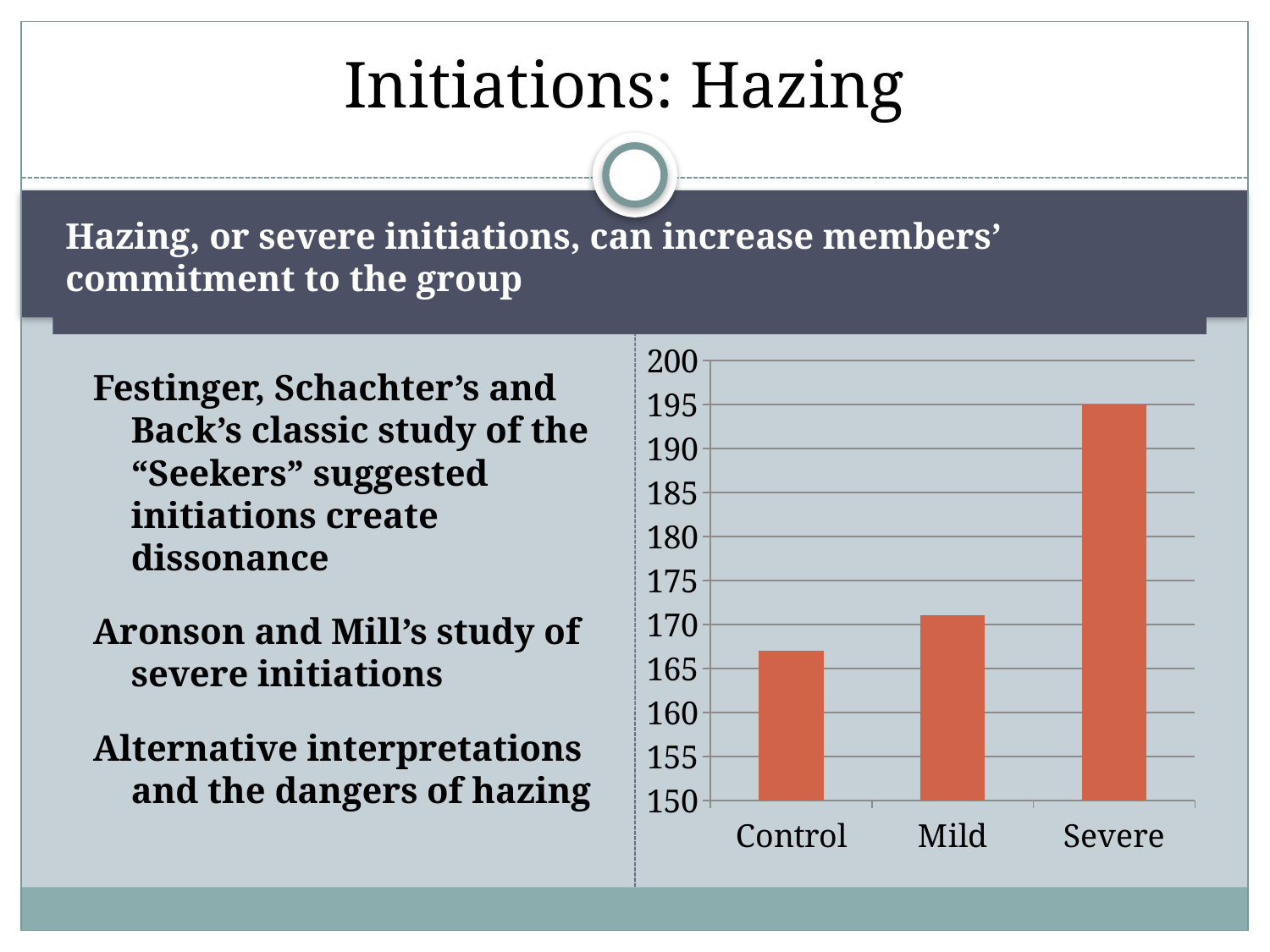
Is the value for Control greater or less than 170? less Which category has the lowest bar? Control What colour are the bars in the chart? orange-red Do the values rise or fall moving from Control to Severe along the x axis? rise Is the value for Severe greater or less than 190? greater What kind of chart is shown on the slide? bar chart What is the lowest value shown on the vertical axis? 150 What is the value for Severe? 195 Which category has the highest bar? Severe How many categories are plotted on the chart? 3 Which is larger, the value for Mild or the value for Severe? Severe